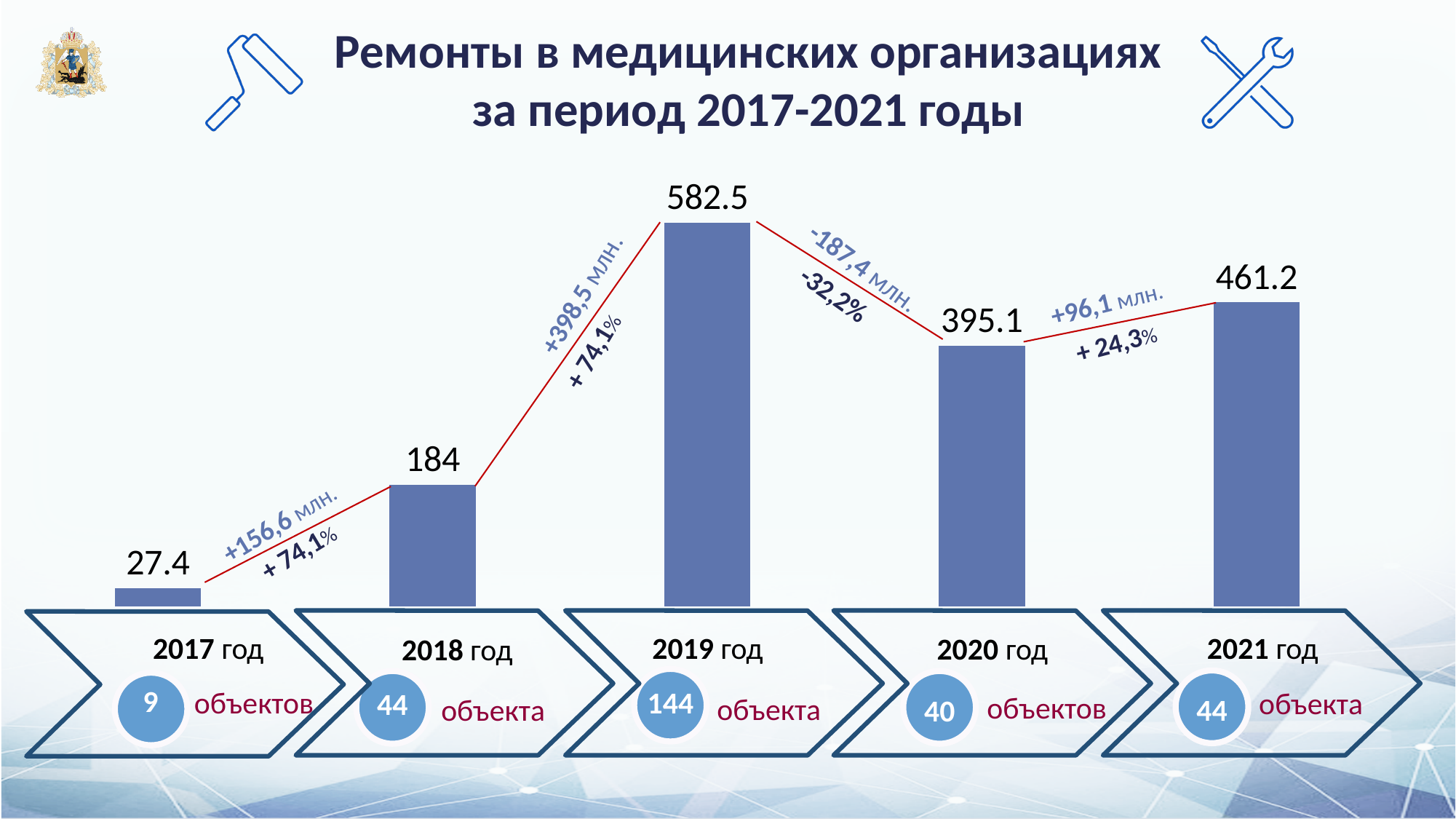
What is the value shown for 2019 год? 582.5 What is the difference between the values for 2021 год and 2020 год? 96.1 Which is larger, the value for 2018 год or the value for 2020 год? 2020 год What is the value shown for 2021 год? 461.2 Which year has the highest bar? 2019 год How many объектов are listed under 2019 год? 144 What kind of chart is shown on the slide? bar chart What is the value shown for 2017 год? 27.4 What is the title of the slide? Ремонты в медицинских организациях за период 2017-2021 годы How many years (bars) are shown in the chart? 5 What is the difference between the values for 2019 год and 2020 год? 187.4 Which year has the lowest bar? 2017 год